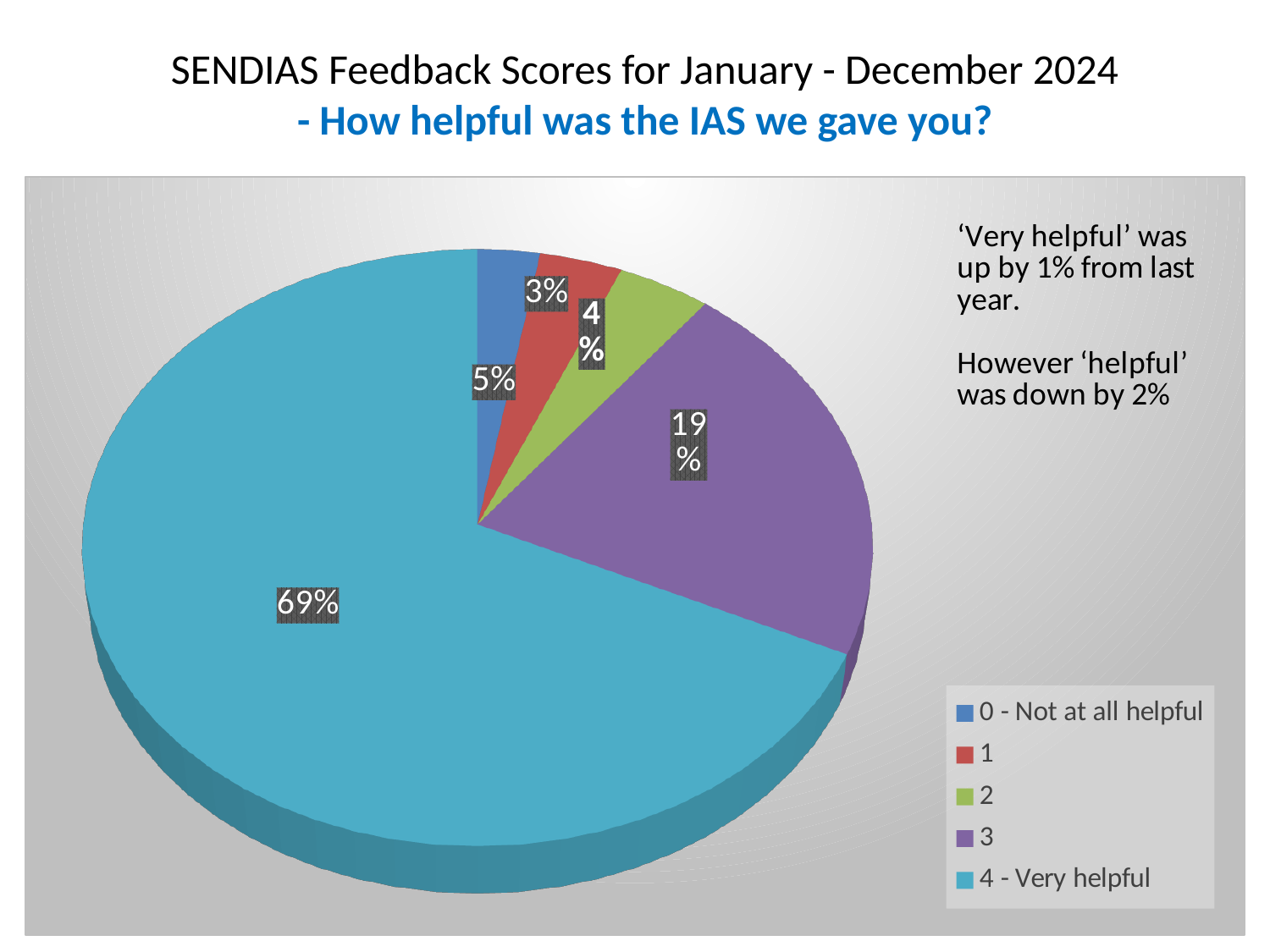
What is the difference in percentage points between '4 - Very helpful' and '3'? 50 Which is larger, the share for '0 - Not at all helpful' or the share for '2'? 0 - Not at all helpful What percentage of responses were '1'? 3% What percentage of responses were '4 - Very helpful'? 69% What percentage of responses were '0 - Not at all helpful'? 5% Which category has the largest share of the pie? 4 - Very helpful Which category has the smallest share of the pie? 1 How many categories does the legend list? 5 What percentage of responses were '3'? 19% What colour is the '3' slice in the pie chart? purple What kind of chart is shown on the slide? pie chart What percentage of responses were '2'? 4%